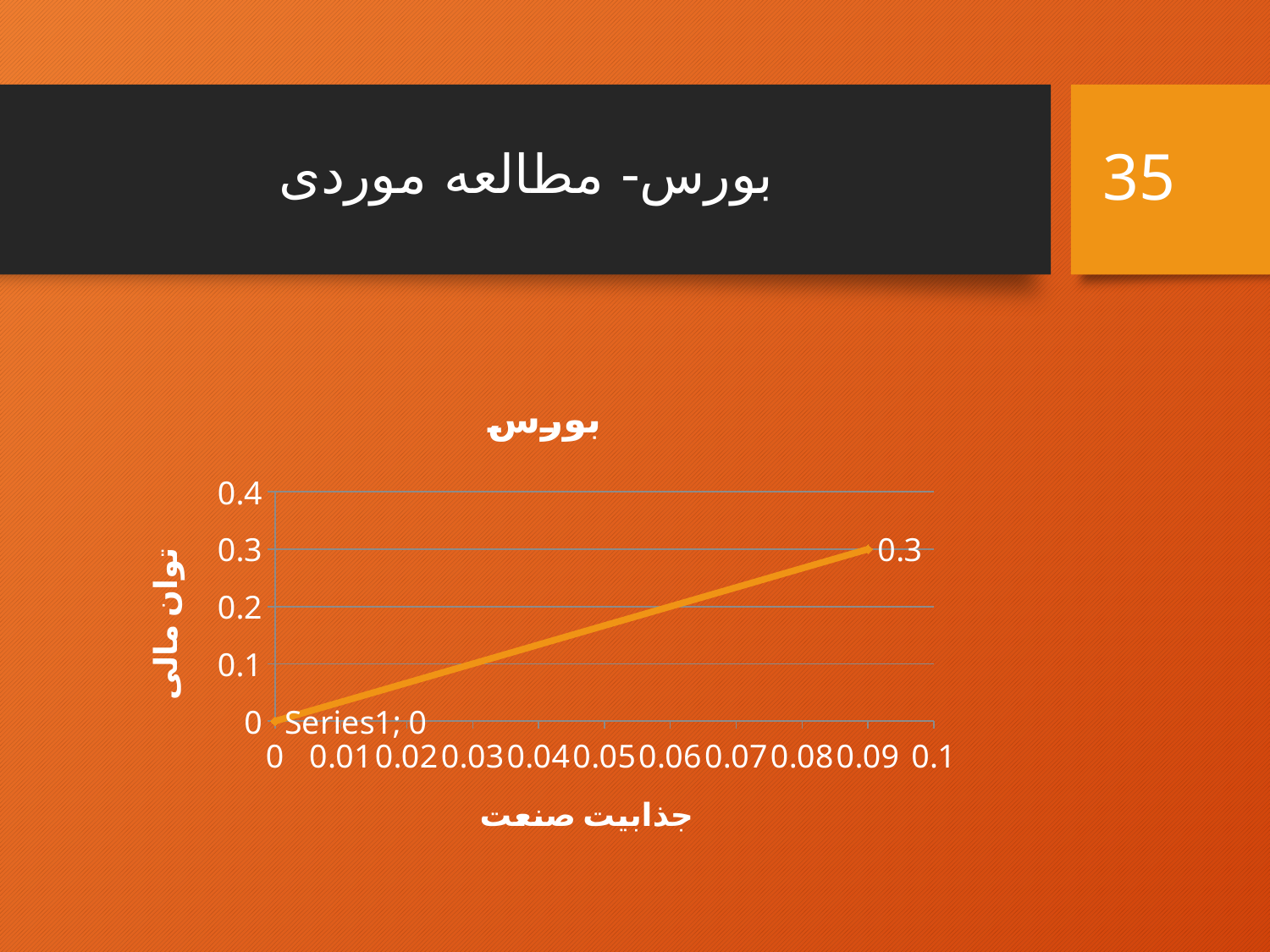
What is the difference between the highest and lowest plotted values? 0.3 What is the highest tick value shown on the vertical axis? 0.4 Does the line rise or fall as you move from left to right along the x axis? rise What is the label of the vertical axis? توان مالی What is the highest plotted value on the chart? 0.3 Is the value at the right end of the line greater or less than 0.2? greater What is the data label shown at the upper-right end of the line? 0.3 What is the title of the chart on the slide? بورس What is the data label shown at the starting point of the line? Series1; 0 How many data points are plotted on the chart? 2 What is the lowest plotted value on the chart? 0 What kind of chart is shown on the slide? line chart